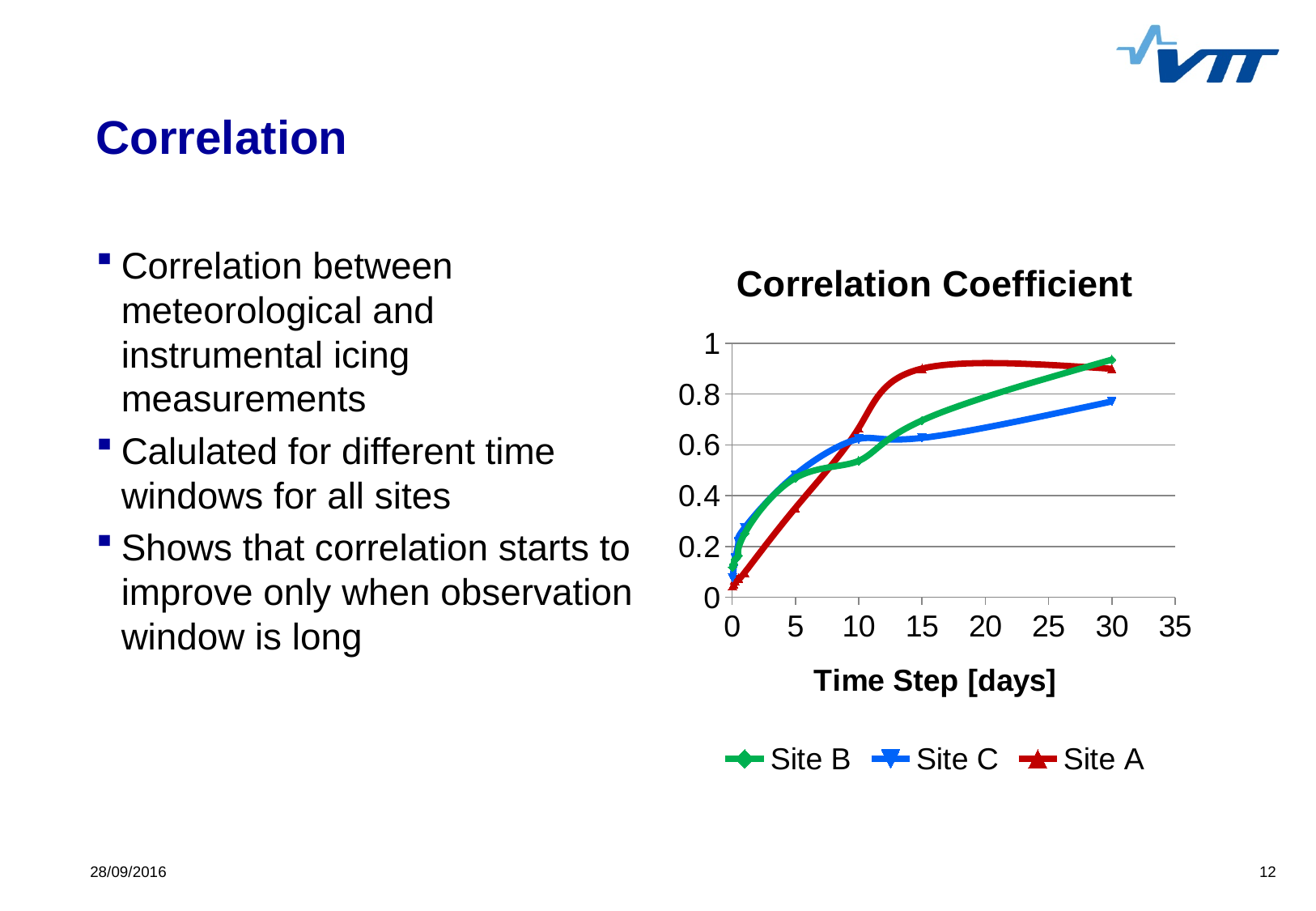
Is the value for Site A at a time step of 15 days greater or less than 0.8? greater Is the value for Site B at a time step of 10 days greater or less than 0.6? less What kind of chart is shown on the slide? line chart What is the title of the chart? Correlation Coefficient Is the value for Site C at a time step of 30 days greater or less than 0.8? less How many series does the legend of the Correlation Coefficient chart list? 3 At a time step of 30 days, which has the larger correlation coefficient, Site C or Site A? Site A At a time step of 15 days, which has the larger correlation coefficient, Site A or Site C? Site A Does the correlation coefficient for Site C generally rise or fall as the time step increases? rise What is the label of the x axis of the chart? Time Step [days]